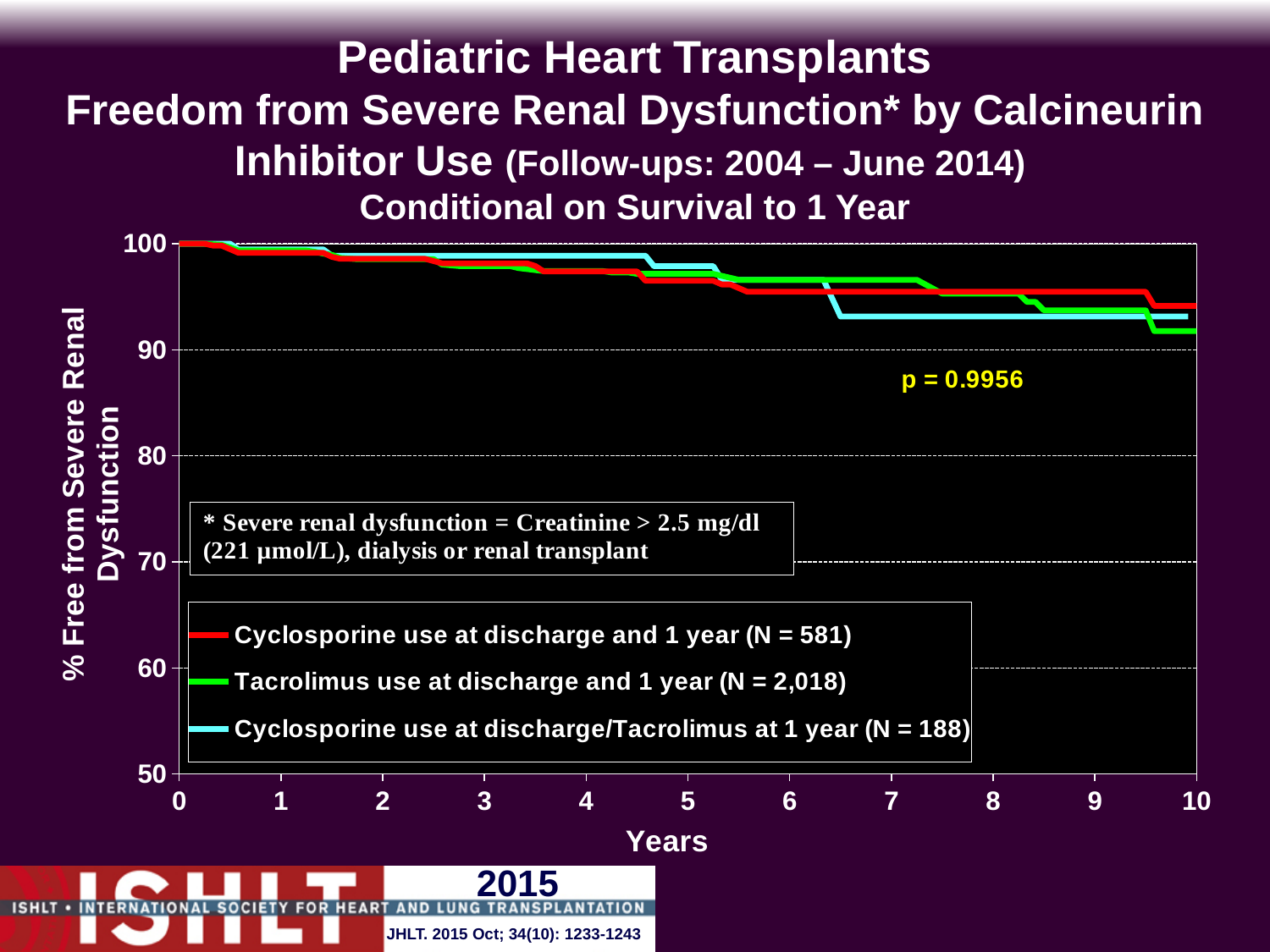
What is the maximum value shown on the x axis? 10 Is the value for the Cyclosporine use at discharge/Tacrolimus at 1 year curve at year 8 greater or less than 90? greater What is the value of all three curves at year 0? 100 Do the curves rise or fall as the years increase along the x axis? fall Is the value for the Tacrolimus use at discharge and 1 year curve at year 10 greater or less than 90? greater What is the N for the Tacrolimus use at discharge and 1 year group shown in the legend? 2,018 What p-value is printed on the chart? p = 0.9956 How many series does the legend list? 3 Is the value for the Cyclosporine use at discharge and 1 year curve at year 5 greater or less than 90? greater What kind of chart is shown on the slide? line chart What is the lowest value shown on the y axis? 50 At year 10, which curve is higher: Cyclosporine use at discharge and 1 year, or Tacrolimus use at discharge and 1 year? Cyclosporine use at discharge and 1 year